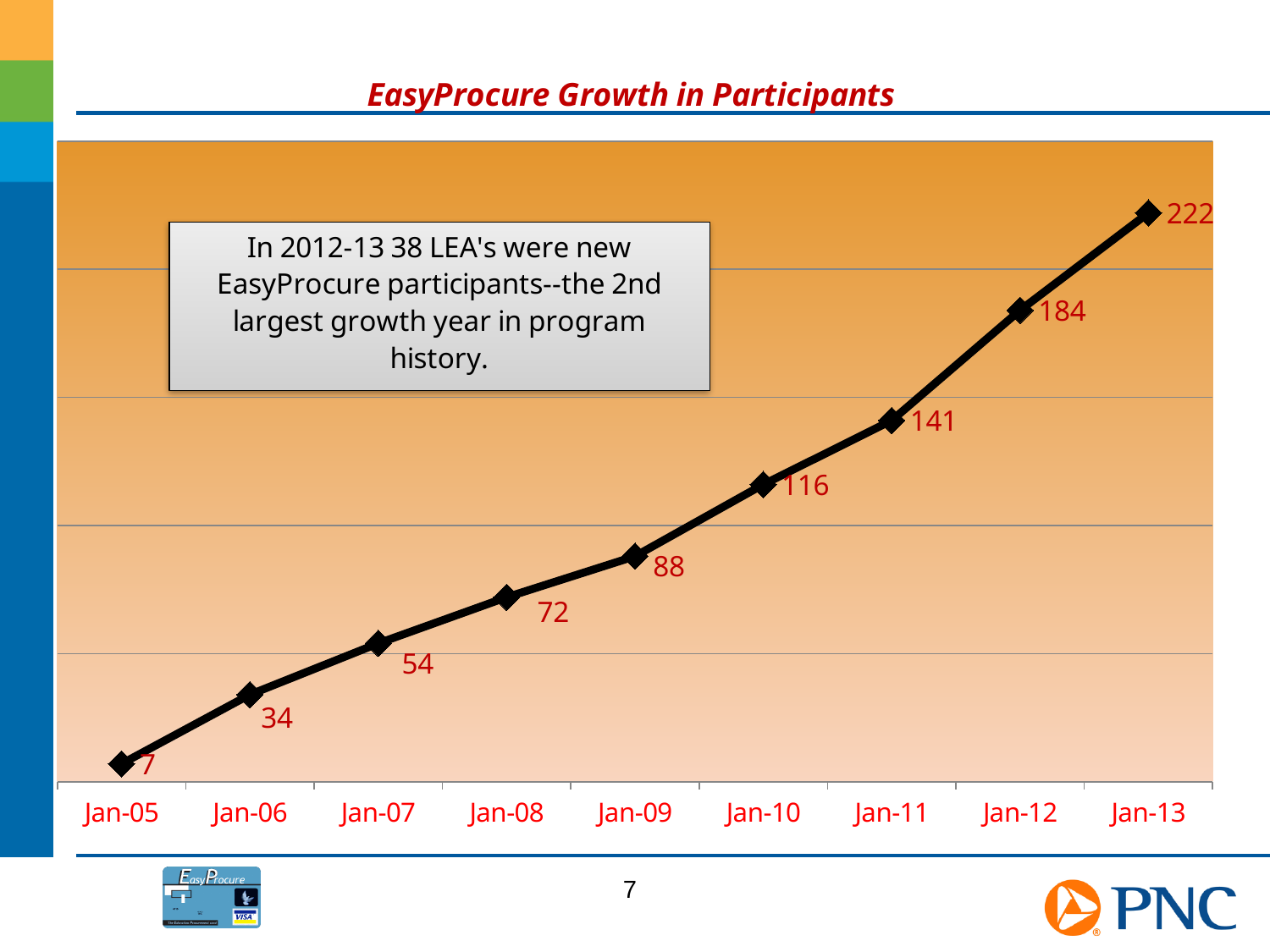
How many data points are plotted on the chart? 9 Which date has the lowest value? Jan-05 Do the values rise or fall from Jan-05 to Jan-13? rise What is the difference between the values for Jan-13 and Jan-12? 38 What is the value for Jan-12? 184 What is the title of the chart? EasyProcure Growth in Participants What is the difference between the values for Jan-11 and Jan-10? 25 What is the value for Jan-09? 88 Which date has the highest value? Jan-13 Which is larger, the value for Jan-07 or the value for Jan-08? Jan-08 What is the value for Jan-05? 7 What kind of chart is shown? line chart